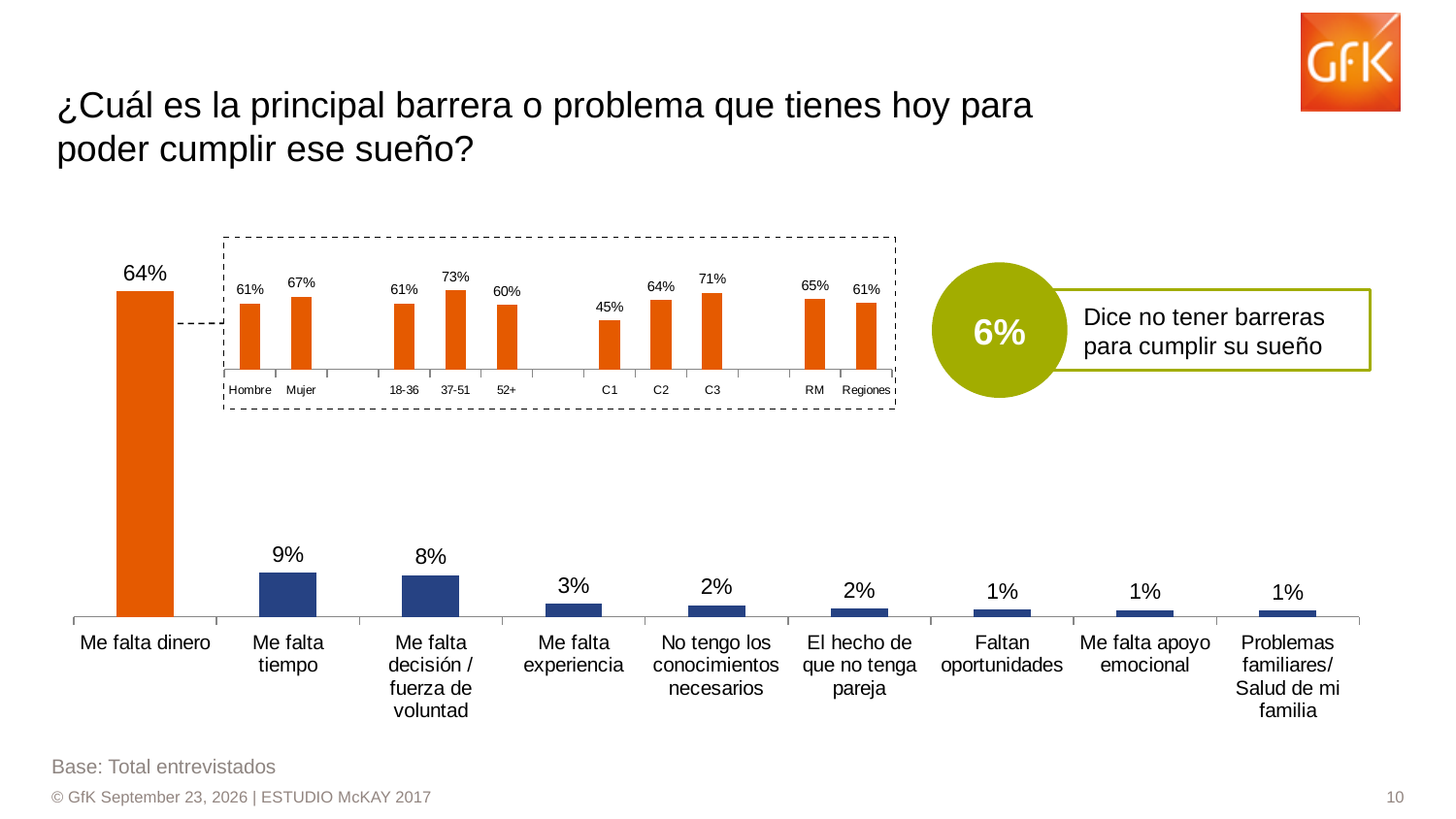
In the main bar chart, which category has the highest value? Me falta dinero In the main bar chart, what is the difference between "Me falta dinero" and "Me falta decisión / fuerza de voluntad"? 56% In the inset chart (breakdown of "Me falta dinero"), what is the value for C1? 45% In the main bar chart, which is larger: "Me falta tiempo" or "Me falta experiencia"? Me falta tiempo What percentage in the green circle says they have no barriers to fulfilling their dream? 6% In the inset chart (breakdown of "Me falta dinero"), what is the difference between Mujer and Hombre? 6% In the main bar chart, do the values rise or fall from left to right? Fall In the inset chart (breakdown of "Me falta dinero"), which group has the highest value? 37-51 In the main bar chart, what is the value for "Me falta dinero"? 64% What kind of chart is the main chart on the slide? Bar chart In the main bar chart, what is the value for "Me falta tiempo"? 9% How many categories does the main bar chart show? 9